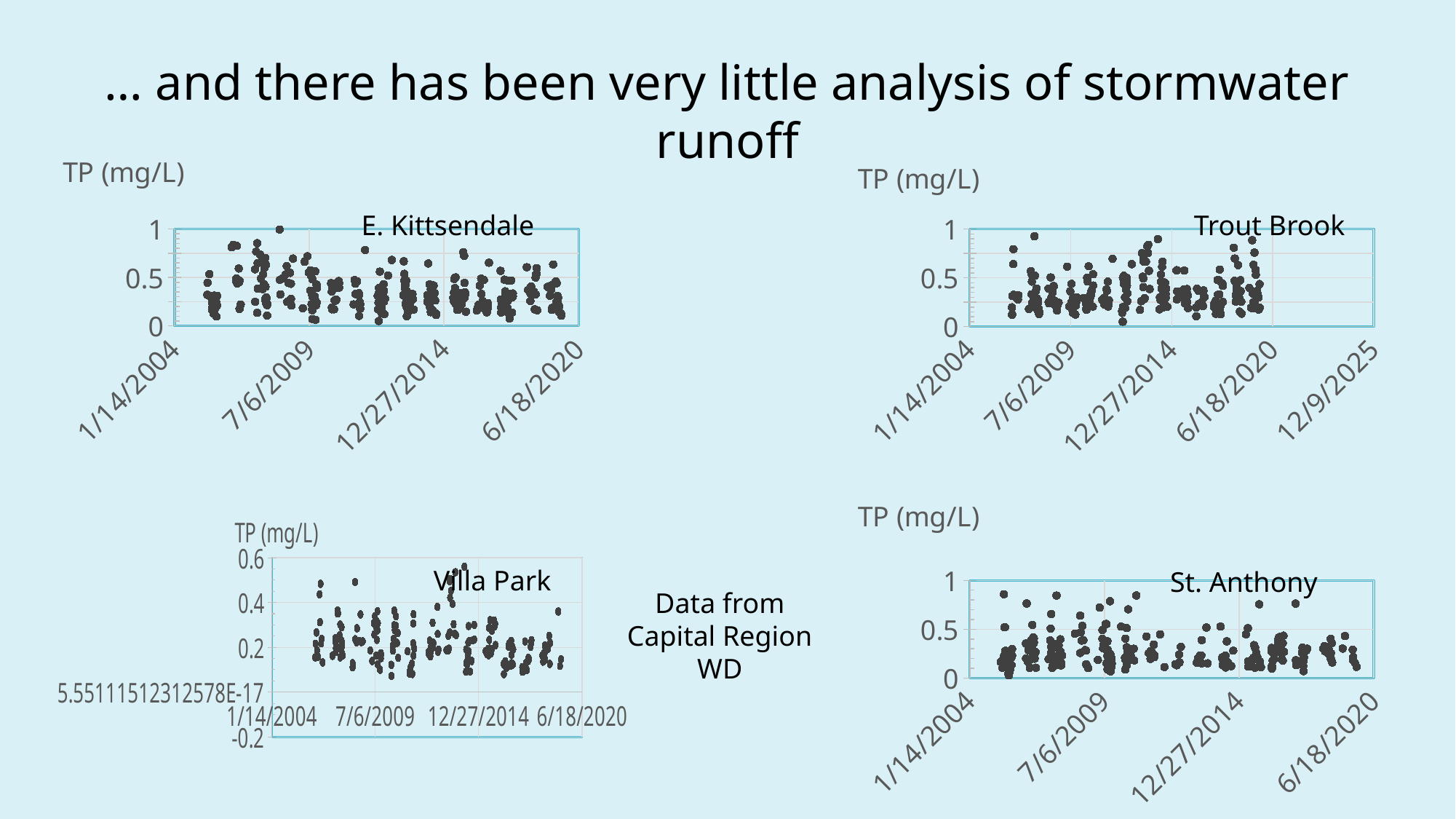
What is the y-axis label on the Trout Brook chart? TP (mg/L) On the E. Kittsendale chart, is the lowest plotted value greater or less than 0.5? less On the E. Kittsendale chart, is the highest plotted value greater or less than 0.5? greater On the Villa Park chart, is the lowest plotted value greater or less than 0.4? less What kind of chart is the St. Anthony chart? scatter chart How many charts are shown on the slide? 4 What is the last x-axis tick label on the Trout Brook chart? 12/9/2025 What kind of chart is the E. Kittsendale chart? scatter chart